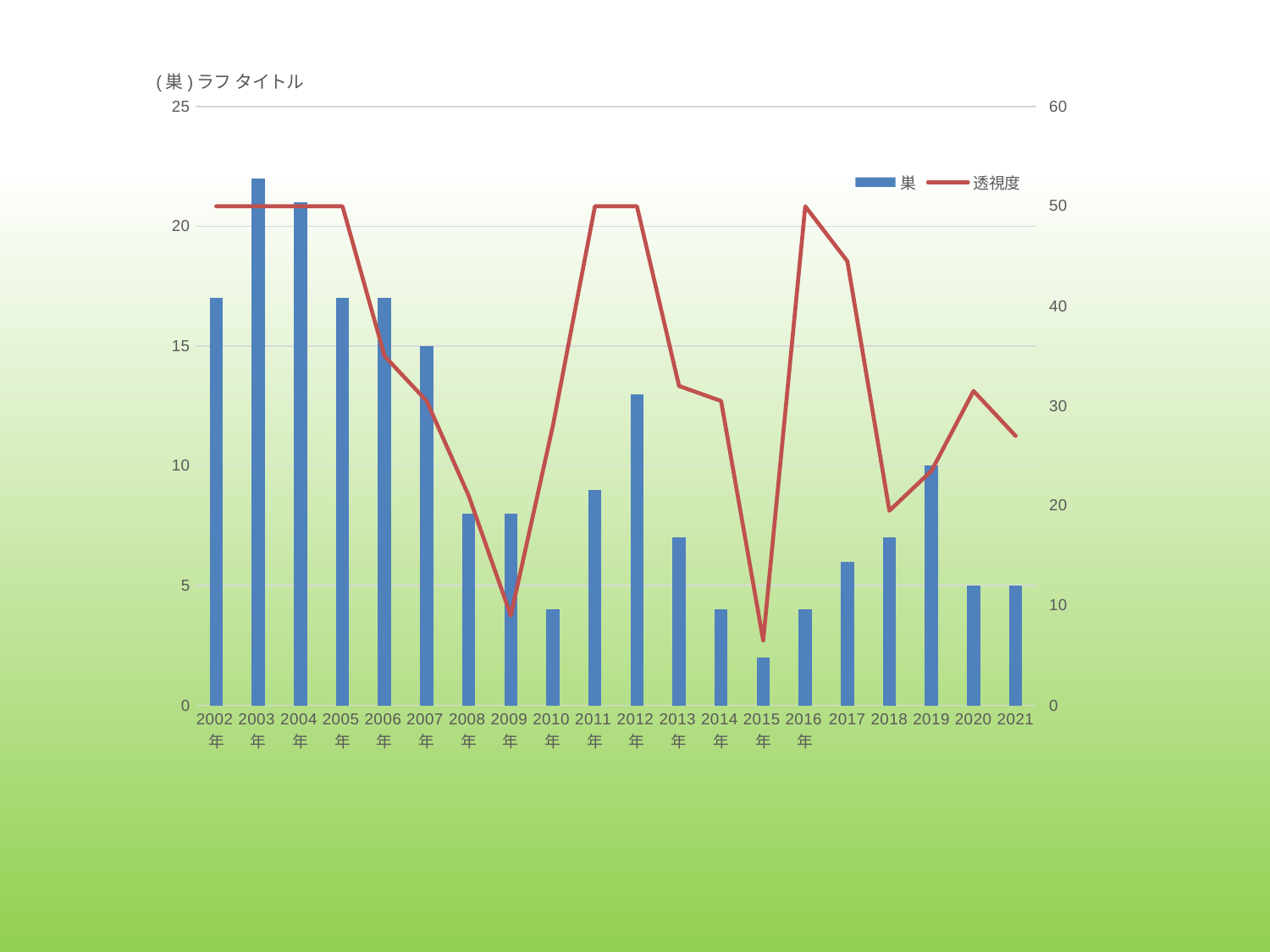
How many series does the legend list? 2 Does the 透視度 line rise or fall from 2012 to 2015? fall What kind of chart is used to plot the 巣 series? bar chart Is the 透視度 value for 2015 greater or less than 10? less How many years are shown on the x axis? 20 What is the 巣 value for 2020? 5 Which year has the larger 巣 value, 2011 or 2012? 2012年 What is the 透視度 value for 2002? 50 What is the 巣 value for 2019? 10 Which year has the lowest 巣 bar? 2015年 Which year has the highest 巣 bar? 2003年 Is the 巣 value for 2002 greater or less than 15? greater